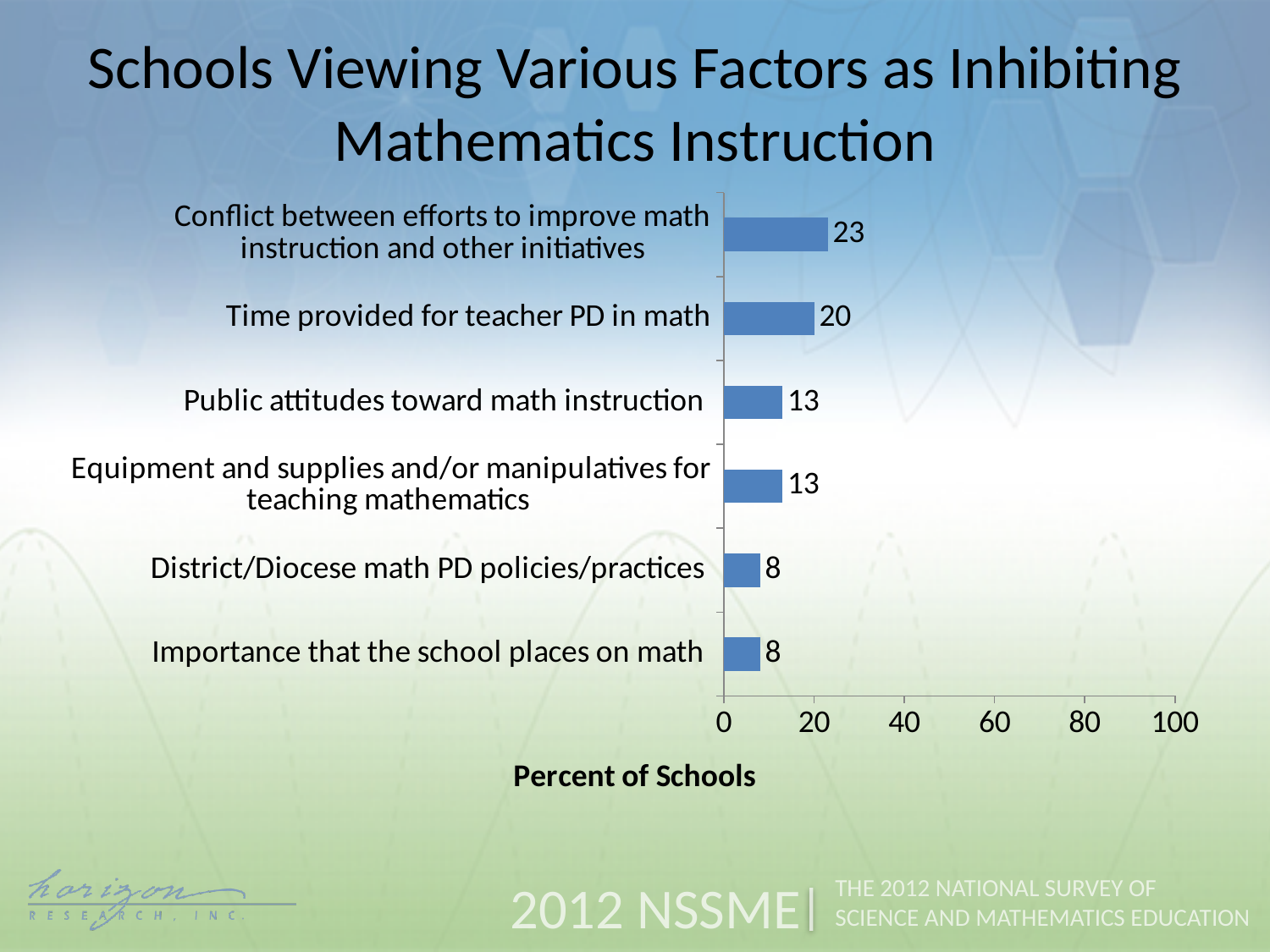
Which is larger: the value for 'Public attitudes toward math instruction' or the value for 'District/Diocese math PD policies/practices'? Public attitudes toward math instruction Is the value for 'Conflict between efforts to improve math instruction and other initiatives' greater or less than 40? less What is the label of the horizontal axis? Percent of Schools What is the value for 'District/Diocese math PD policies/practices'? 8 What kind of chart is shown on the slide? Bar chart What is the difference between the values for 'Time provided for teacher PD in math' and 'Importance that the school places on math'? 12 How many factors are shown in the chart? 6 Which factor has the highest percent of schools? Conflict between efforts to improve math instruction and other initiatives What is the value for 'Time provided for teacher PD in math'? 20 What is the value for 'Public attitudes toward math instruction'? 13 What percent of schools view conflict between efforts to improve math instruction and other initiatives as inhibiting mathematics instruction? 23 What is the difference between the values for 'Conflict between efforts to improve math instruction and other initiatives' and 'Time provided for teacher PD in math'? 3